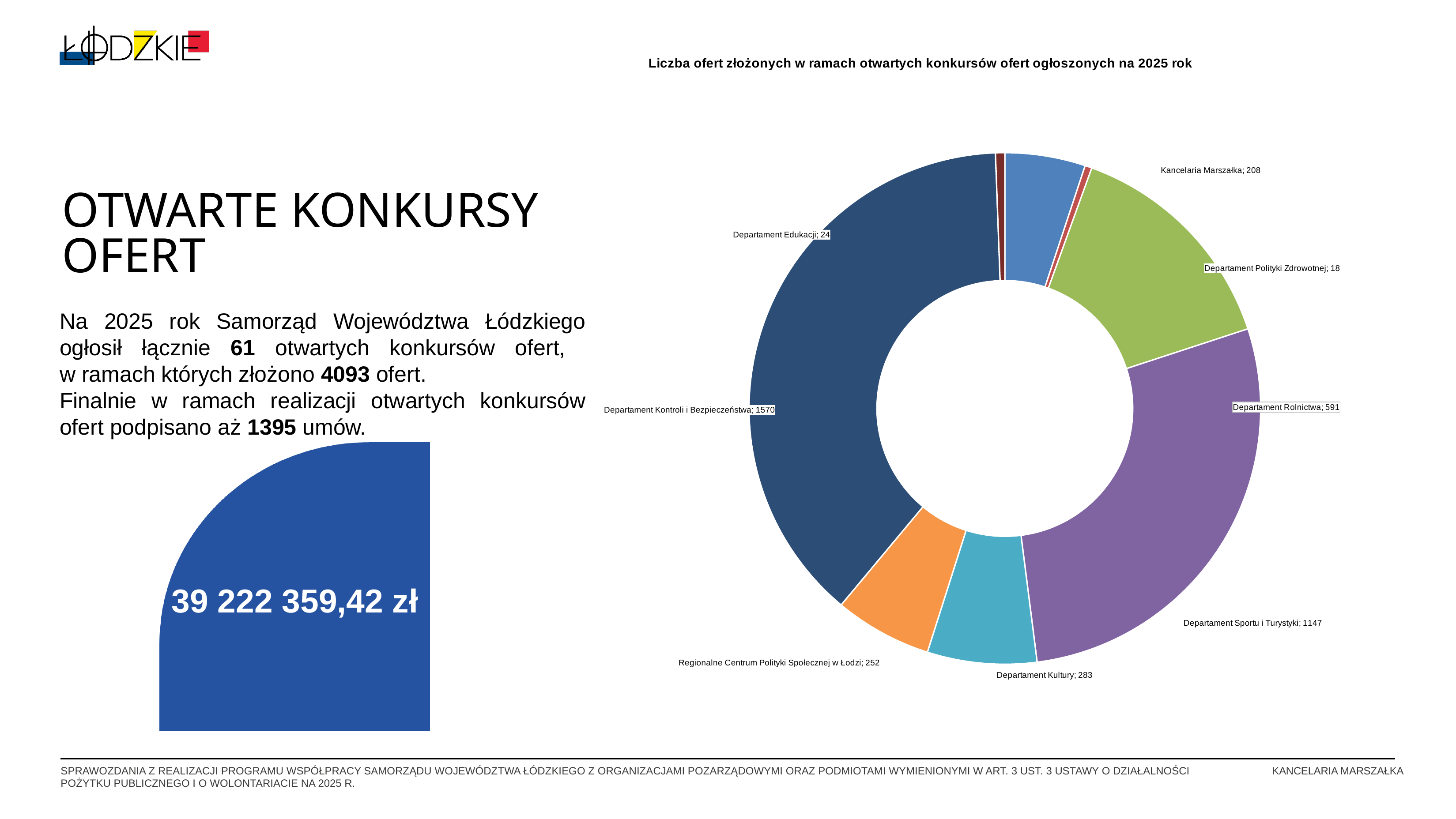
How many categories (slices) does the chart show? 8 What is the total of all the values shown in the chart? 4093 What is the title of the chart? Liczba ofert złożonych w ramach otwartych konkursów ofert ogłoszonych na 2025 rok What is the value for Departament Rolnictwa? 591 Which category has the highest value? Departament Kontroli i Bezpieczeństwa What kind of chart is shown on the slide? Doughnut (pie) chart Which is larger, the value for Departament Kultury or the value for Kancelaria Marszałka? Departament Kultury What is the value for Regionalne Centrum Polityki Społecznej w Łodzi? 252 Which category has the lowest value? Departament Polityki Zdrowotnej What is the value for Departament Kontroli i Bezpieczeństwa? 1570 What is the difference between the values for Departament Kontroli i Bezpieczeństwa and Departament Sportu i Turystyki? 423 What is the value for Departament Sportu i Turystyki? 1147